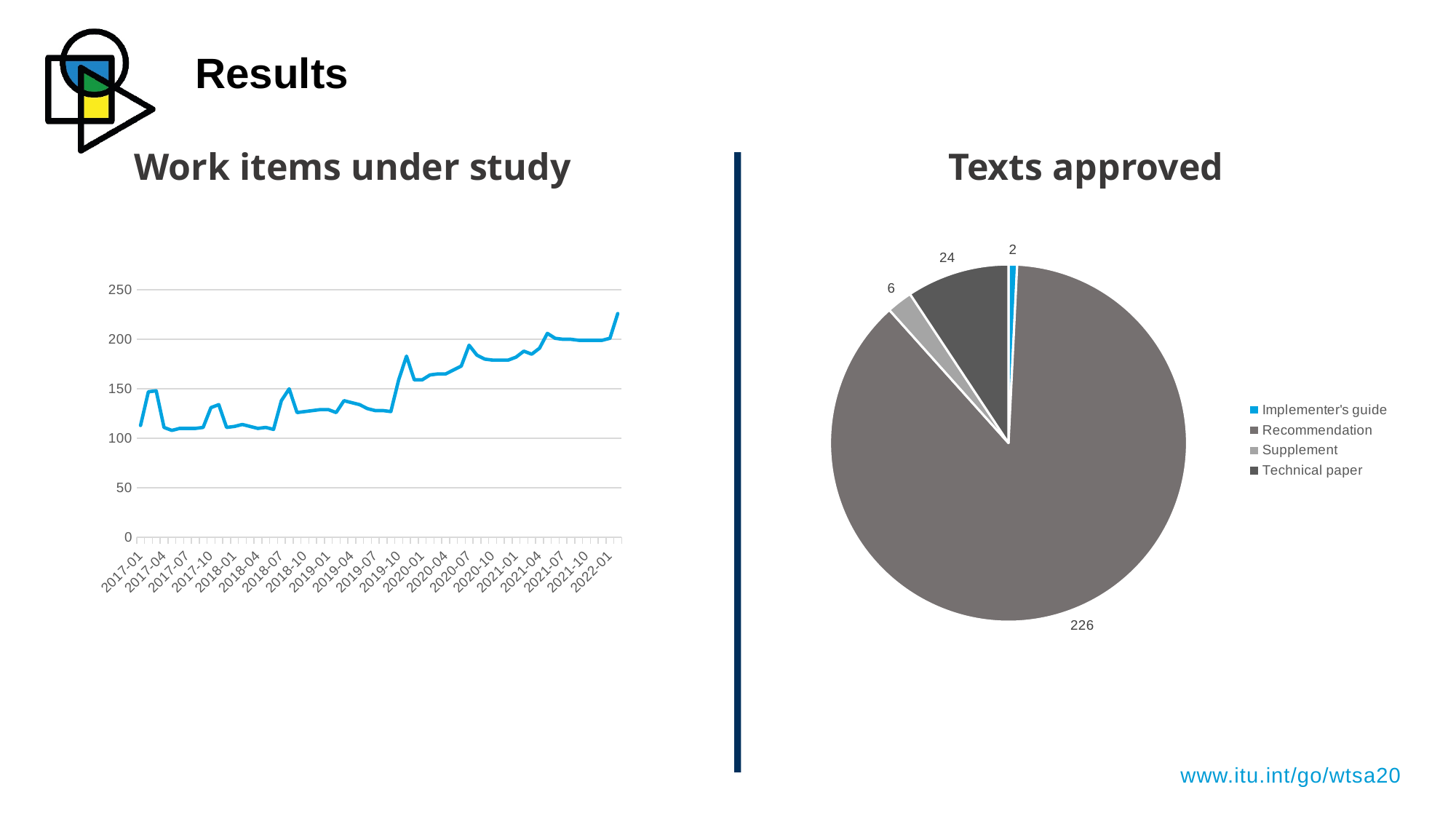
In the 'Texts approved' chart, which category has the largest slice? Recommendation In the 'Texts approved' chart, how many texts are Recommendations? 226 What kind of chart is the 'Texts approved' chart? pie chart In the 'Work items under study' chart, do the values generally rise or fall from 2017-01 to 2022-01? rise In the 'Texts approved' chart, what is the value for Supplement? 6 In the 'Texts approved' chart, how many categories does the legend list? 4 In the 'Texts approved' chart, what is the difference between the Technical paper and Supplement values? 18 In the 'Texts approved' chart, what is the value for Technical paper? 24 What kind of chart is the 'Work items under study' chart? line chart In the 'Texts approved' chart, what is the total of all slices? 258 In the 'Texts approved' chart, which category has the smallest slice? Implementer's guide